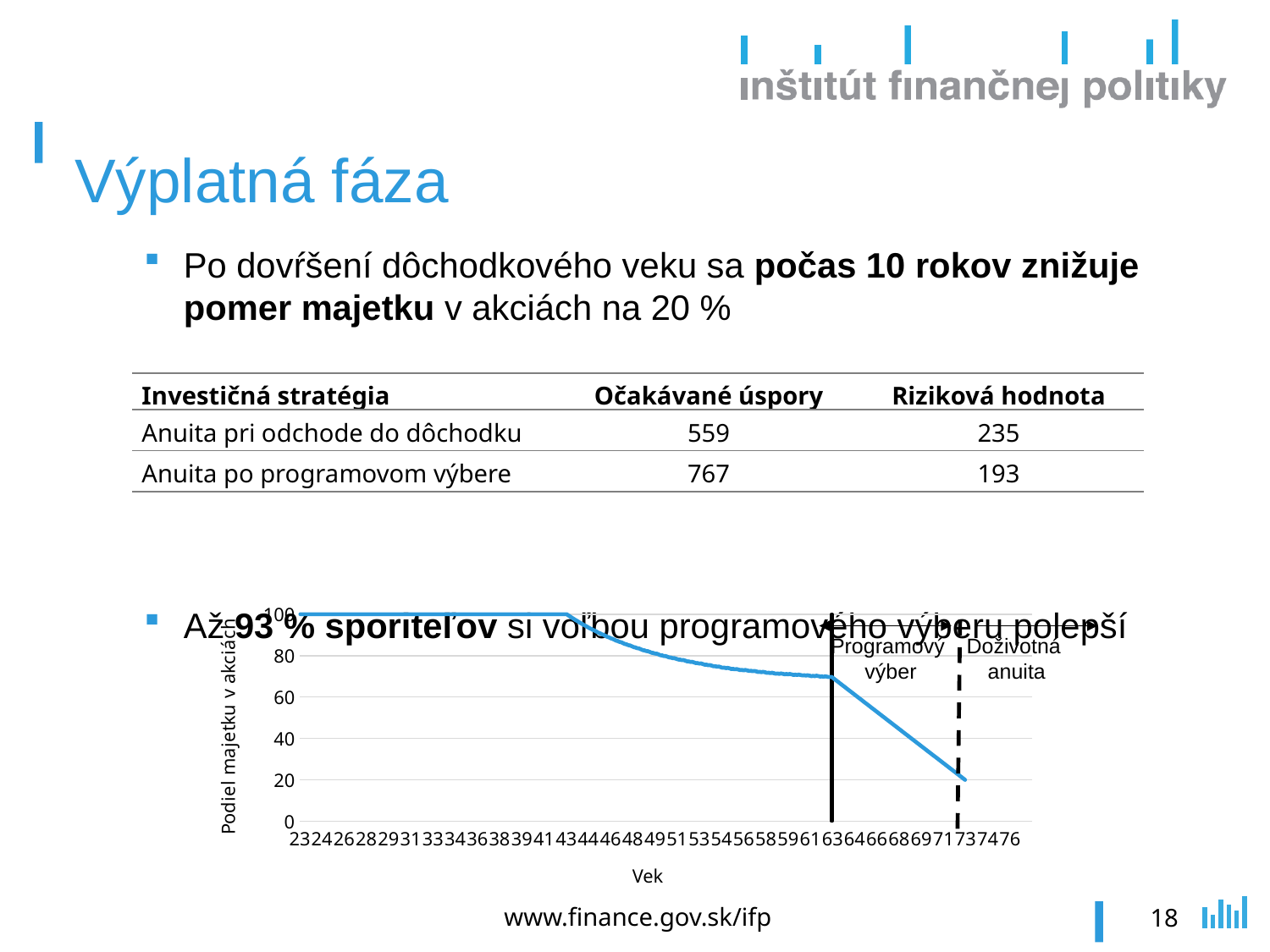
Is the value of the line at age 68 greater or less than 60? less What is the highest tick value shown on the y axis of the line chart? 100 What is the label of the y axis of the line chart? Podiel majetku v akciách Which is larger, the value of the line at age 31 or at age 71? age 31 What value does the line reach at the dashed vertical line labelled 'Doživotná anuita'? 20 Is the value of the line at age 63 greater or less than 60? greater What kind of chart is shown at the bottom of the slide? line chart What is the label of the x axis of the line chart? Vek Does the line in the chart rise or fall as age increases from 41 to 76? fall Is the value of the line at age 36 greater or less than 80? greater What value does the line start at for age 23? 100